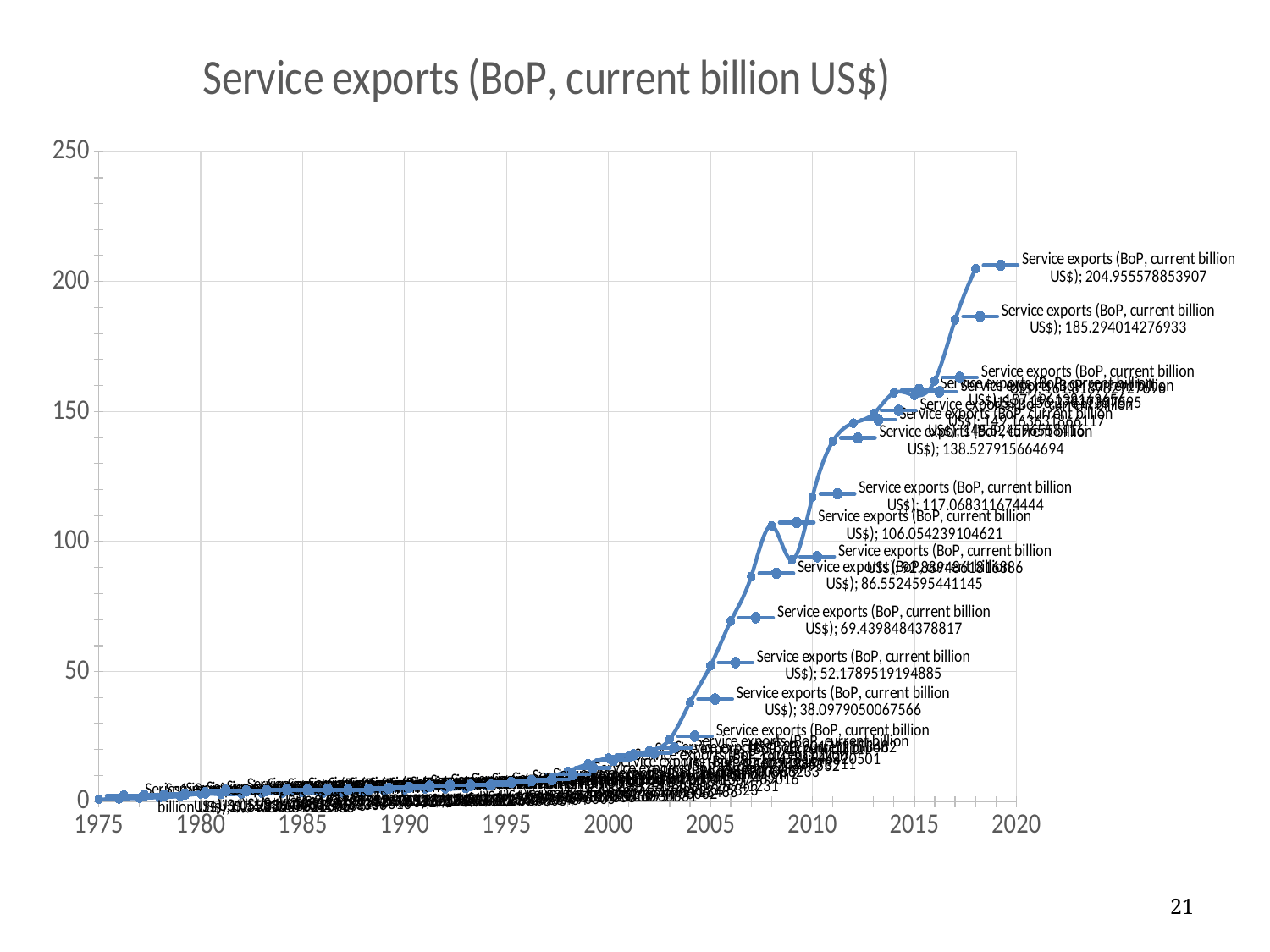
What kind of chart is shown on the slide? line chart Is the value for 2000 greater or less than 50? less What is the second-highest value labelled on the chart? 185.294014276933 What is the difference between the two highest labelled values, 204.955578853907 and 185.294014276933? 19.661564576974 What is the highest value labelled on the chart? 204.955578853907 What is the maximum value shown on the vertical axis? 250 Is the value for 1990 greater or less than 50? less Which year has the larger value, 2000 or 2010? 2010 What is the title of the chart? Service exports (BoP, current billion US$) Is the value for 2007 greater or less than 50? greater Do service exports generally rise or fall from 1975 to the end of the series? rise